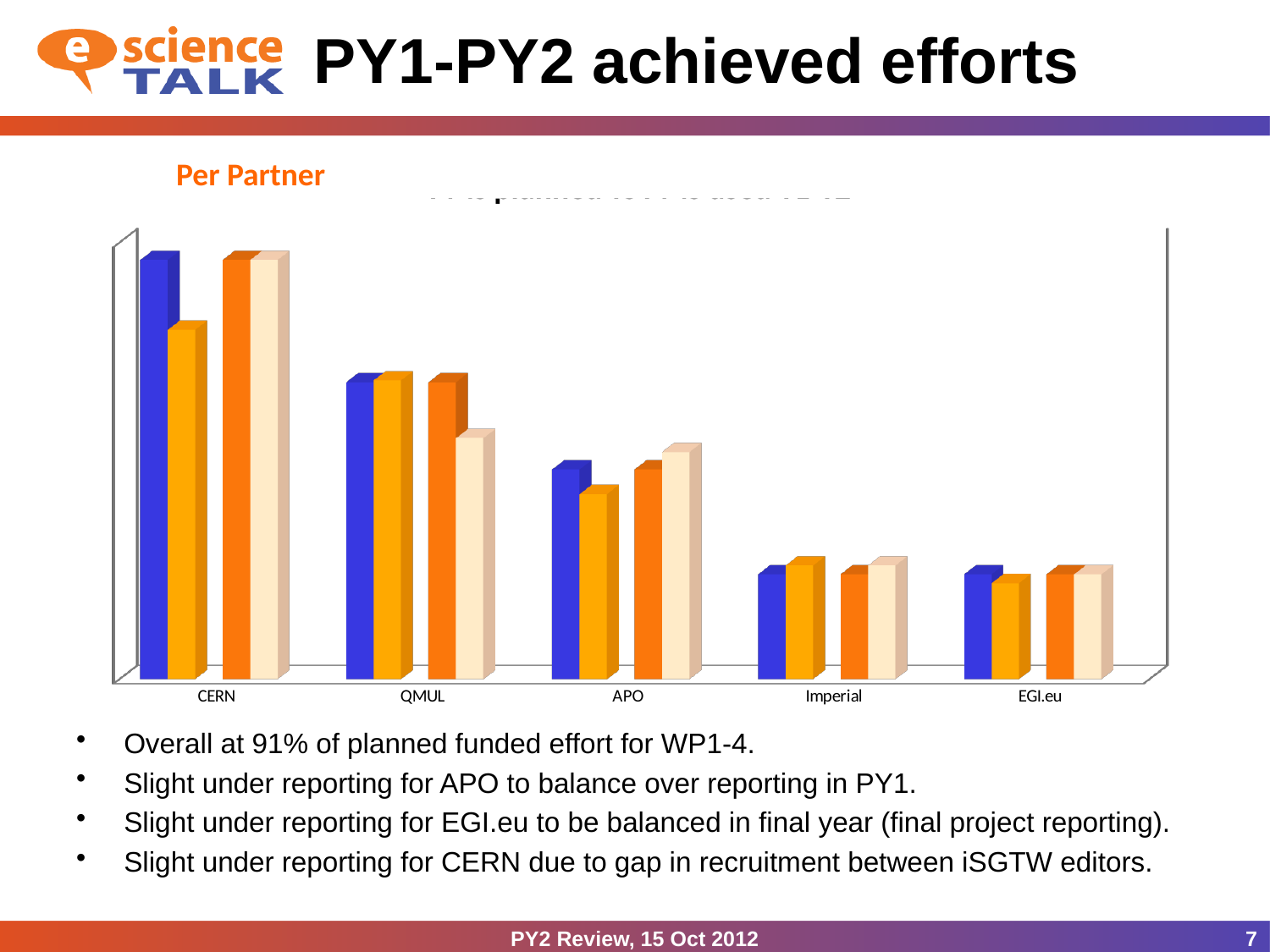
For CERN, is the yellow bar taller or shorter than the blue bar? shorter Which partner has the tallest bars in the chart? CERN What kind of chart is shown on the slide? bar chart How many partner categories are shown on the x axis of the chart? 5 How many bars are plotted for each partner? 4 Is the blue bar for CERN taller or shorter than the blue bar for QMUL? taller Which partner is shown first (leftmost) on the x axis? CERN Is the blue bar for APO taller or shorter than the blue bar for Imperial? taller Do the bar heights generally rise or fall moving from CERN on the left to EGI.eu on the right? fall Which partner is shown last (rightmost) on the x axis? EGI.eu